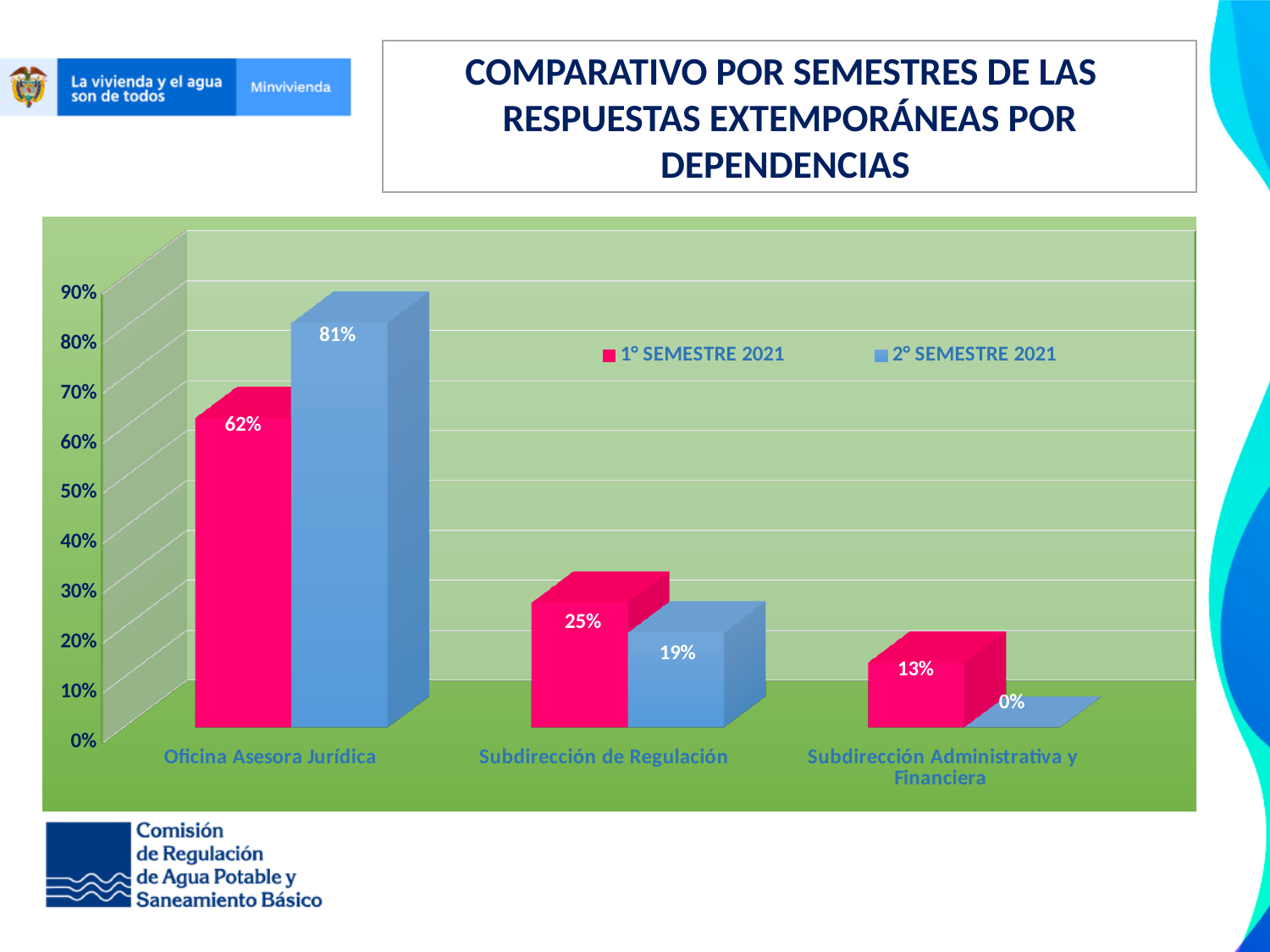
What is the value for Subdirección Administrativa y Financiera in the 2° SEMESTRE 2021 series? 0% Do the values in the 1° SEMESTRE 2021 series rise or fall from left to right along the x axis? Fall What is the value for Subdirección de Regulación in the 1° SEMESTRE 2021 series? 25% What is the difference between the 2° SEMESTRE 2021 and 1° SEMESTRE 2021 values for Oficina Asesora Jurídica? 19% Which category has the highest value in the 2° SEMESTRE 2021 series? Oficina Asesora Jurídica How many categories are shown on the x axis? 3 Which category has the lowest value in the 1° SEMESTRE 2021 series? Subdirección Administrativa y Financiera How many series does the legend list? 2 What is the value for Oficina Asesora Jurídica in the 2° SEMESTRE 2021 series? 81% For Subdirección de Regulación, which series has the larger value, 1° SEMESTRE 2021 or 2° SEMESTRE 2021? 1° SEMESTRE 2021 What is the value for Oficina Asesora Jurídica in the 1° SEMESTRE 2021 series? 62% What kind of chart is shown on the slide? Bar chart